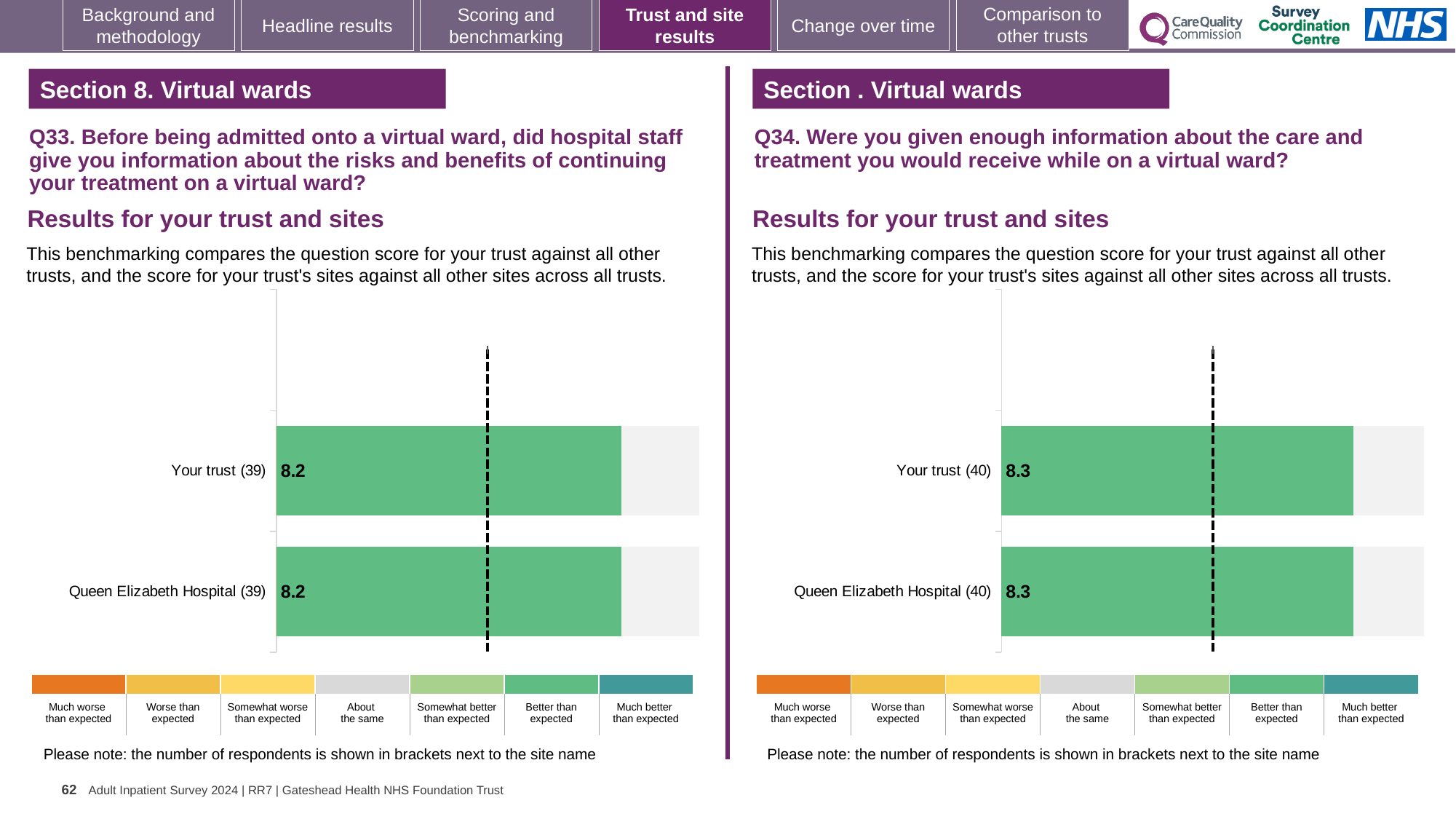
In the Q34 chart on the right, what is the score for Queen Elizabeth Hospital (40)? 8.3 In the Q33 chart on the left, what is the difference between the scores for Your trust and Queen Elizabeth Hospital? 0 What type of chart is used for the Q33 results on the left? Bar chart In the Q34 chart on the right, which benchmark category does the green colour of the bars correspond to in the key? Better than expected How many bars are plotted in the Q34 chart on the right? 2 In the Q33 chart on the left, what is the score for Queen Elizabeth Hospital (39)? 8.2 In the Q34 chart on the right, what is the difference between the scores for Your trust and Queen Elizabeth Hospital? 0 In the Q34 chart on the right, how many respondents are shown in brackets for Your trust? 40 In the Q33 chart on the left, what is the score for Your trust (39)? 8.2 In the Q34 chart on the right, what is the score for Your trust (40)? 8.3 How many bars are plotted in the Q33 chart on the left? 2 In the Q33 chart on the left, how many respondents are shown in brackets for Queen Elizabeth Hospital? 39